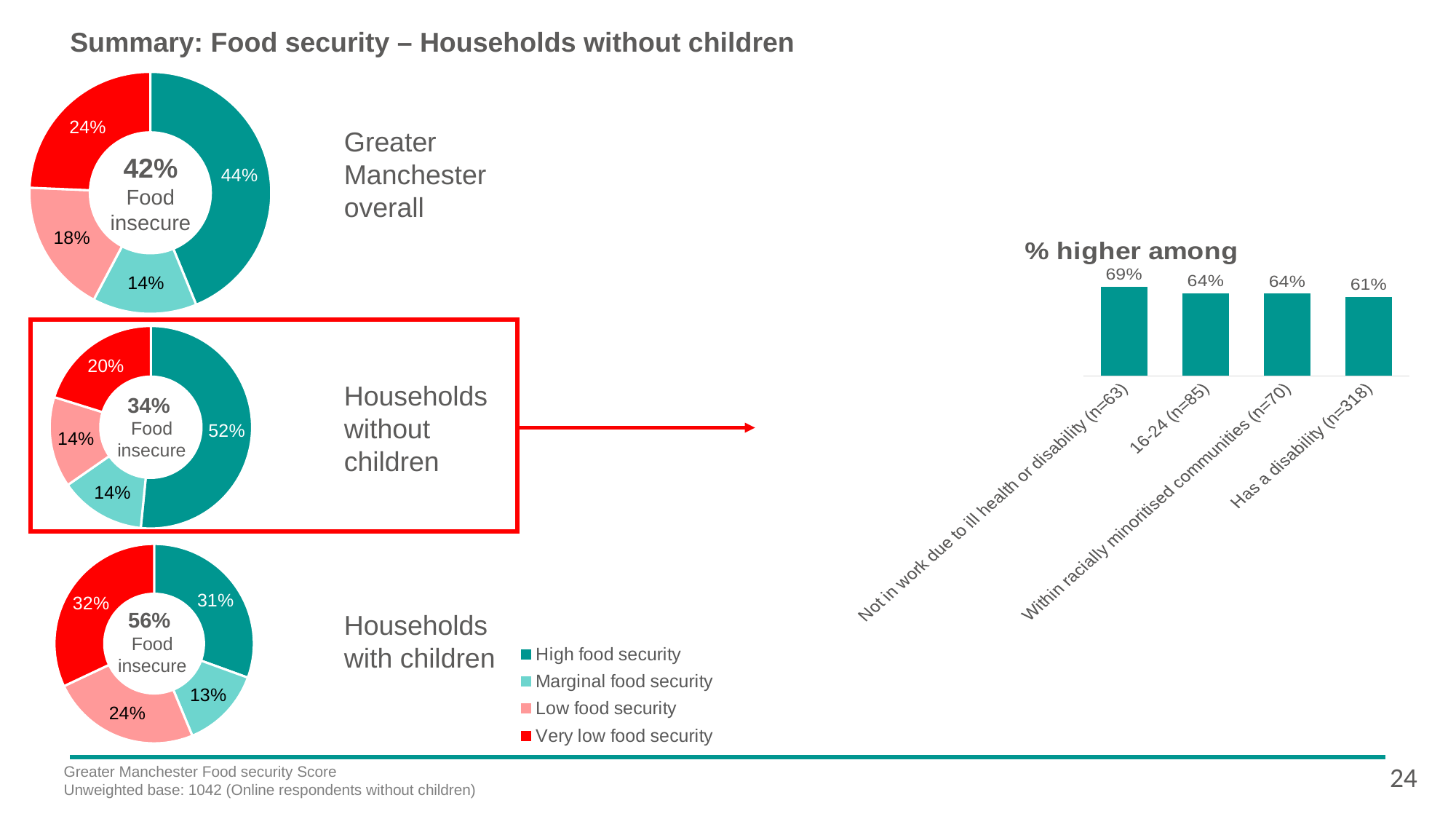
In the '% higher among' bar chart, which category has the lowest value? Has a disability (n=318) How many bars are shown in the '% higher among' bar chart? 4 What type of chart is the '% higher among' chart? Bar chart What percentage is shown in the centre of the 'Households without children' donut chart as food insecure? 34% In the 'Greater Manchester overall' donut chart, what share is labelled for Very low food security? 24% In the 'Households with children' donut chart, which is larger: the Very low food security share or the High food security share? Very low food security In the '% higher among' bar chart, what is the difference between the values for '16-24 (n=85)' and 'Has a disability (n=318)'? 3% In the '% higher among' bar chart, which category has the highest value? Not in work due to ill health or disability (n=63) How many entries does the legend for the donut charts list? 4 In the 'Households with children' donut chart, what share is labelled for Low food security? 24% In the 'Households without children' donut chart, what share is labelled for High food security? 52% In the '% higher among' bar chart, what is the value for 'Not in work due to ill health or disability (n=63)'? 69%